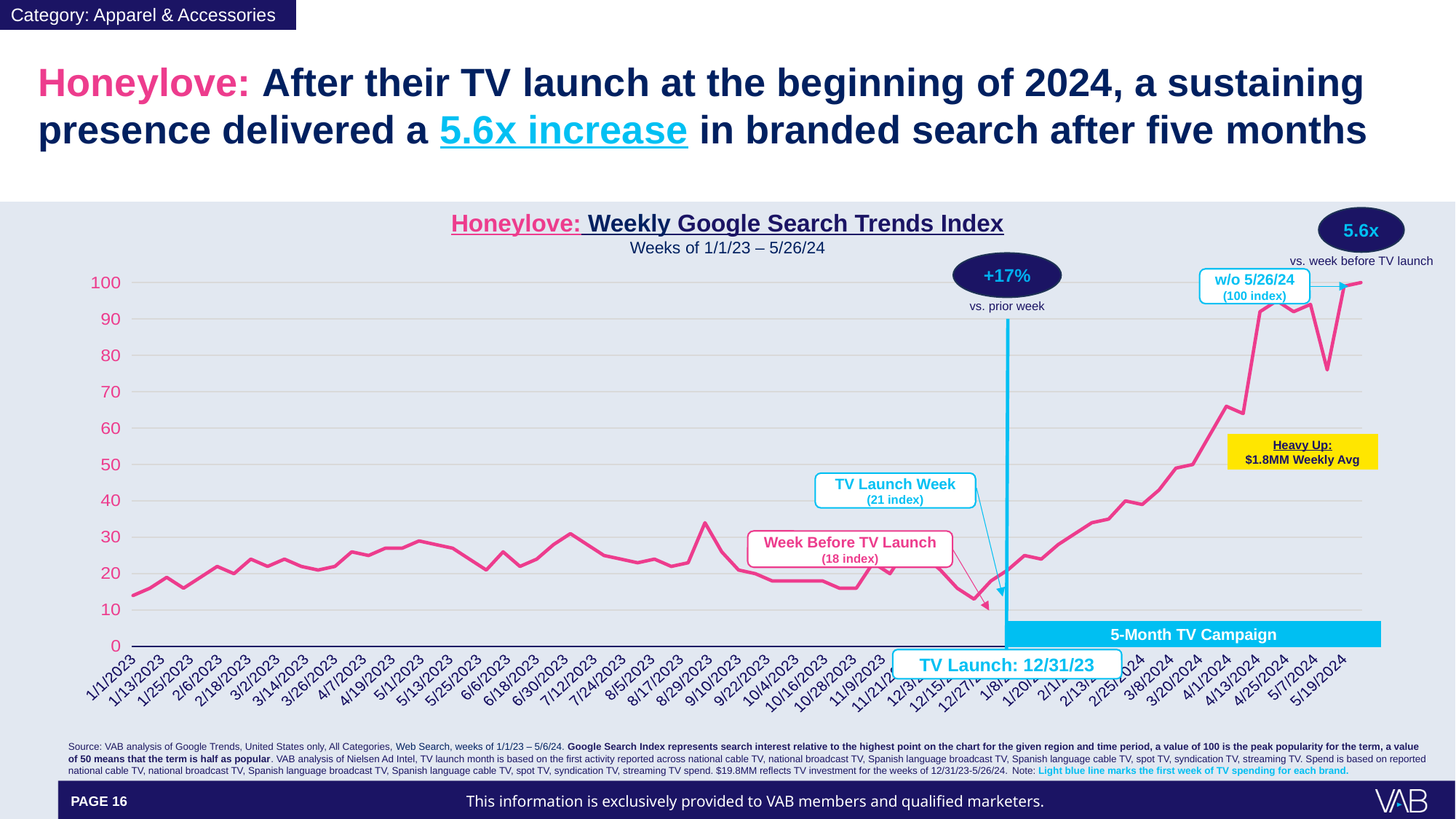
What is the index value for the TV Launch Week? 21 What is the title of the chart? Honeylove: Weekly Google Search Trends Index What is the index value for the Week Before TV Launch? 18 Which is larger, the index for the TV Launch Week or the index for the Week Before TV Launch? TV Launch Week What date is labeled as the TV Launch on the chart? 12/31/23 What is the difference between the index for the week of 5/26/24 and the Week Before TV Launch? 82 Is the index value for 1/1/2023 greater or less than 20? less Which week has the highest index value on the chart? w/o 5/26/24 Do the index values generally rise or fall after the TV launch on 12/31/23? rise What is the difference between the TV Launch Week index and the Week Before TV Launch index? 3 What kind of chart is shown on the slide? line chart What is the index value for the week of 5/26/24? 100